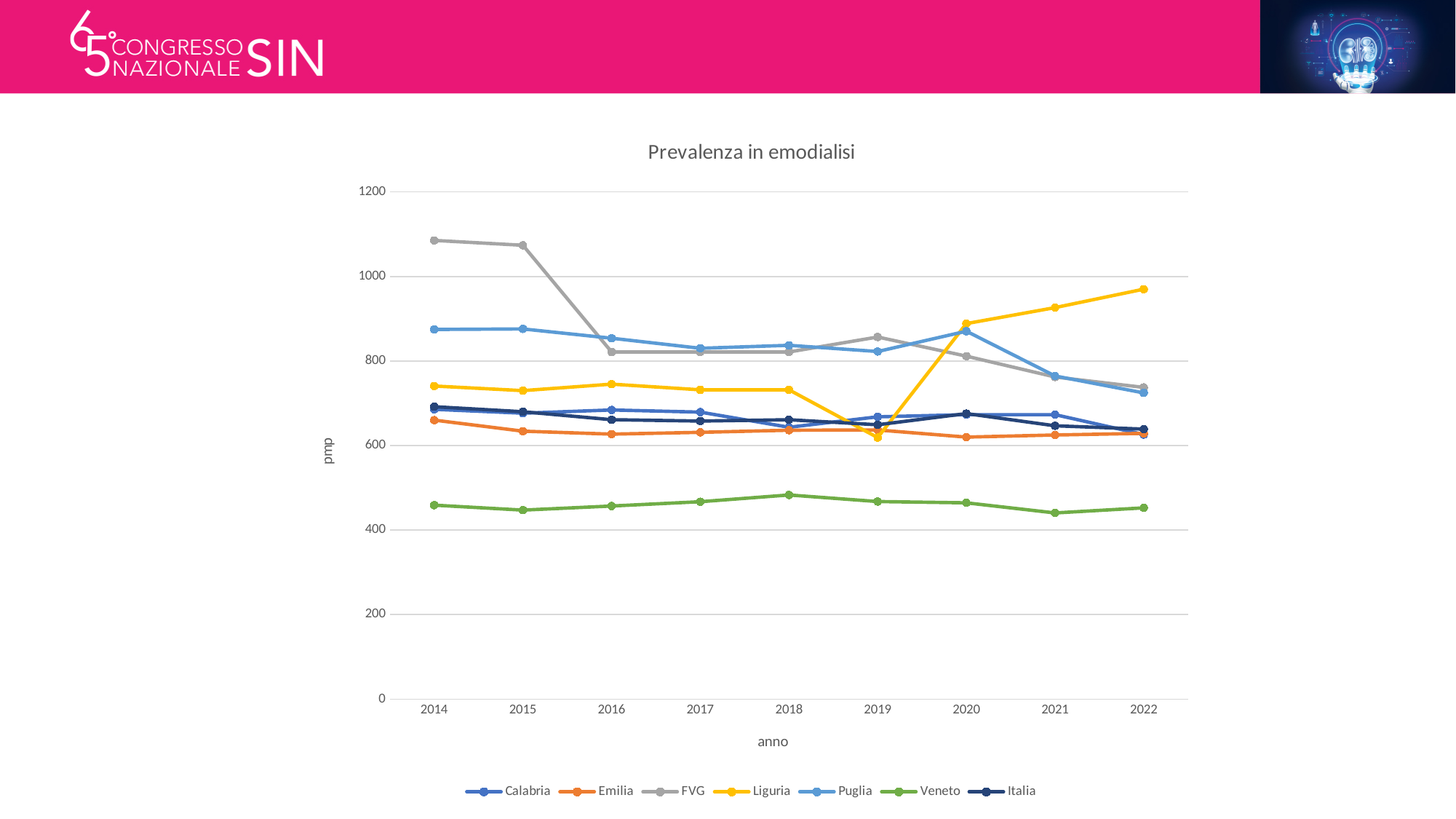
Does the value for Liguria rise or fall from 2019 to 2022? rise Which series has the lowest value in 2018? Veneto In 2022, which is larger: the value for Liguria or the value for Puglia? Liguria Which series has the highest value in 2022? Liguria What is the title of the chart? Prevalenza in emodialisi Is the value for FVG in 2014 greater or less than 1000? greater Is the value for Veneto in 2021 greater or less than 600? less What is the label of the y axis of the chart? pmp What kind of chart is shown on the slide? line chart How many years are plotted along the x axis of the chart? 9 Which series has the highest value in 2014? FVG How many series does the legend of the chart list? 7